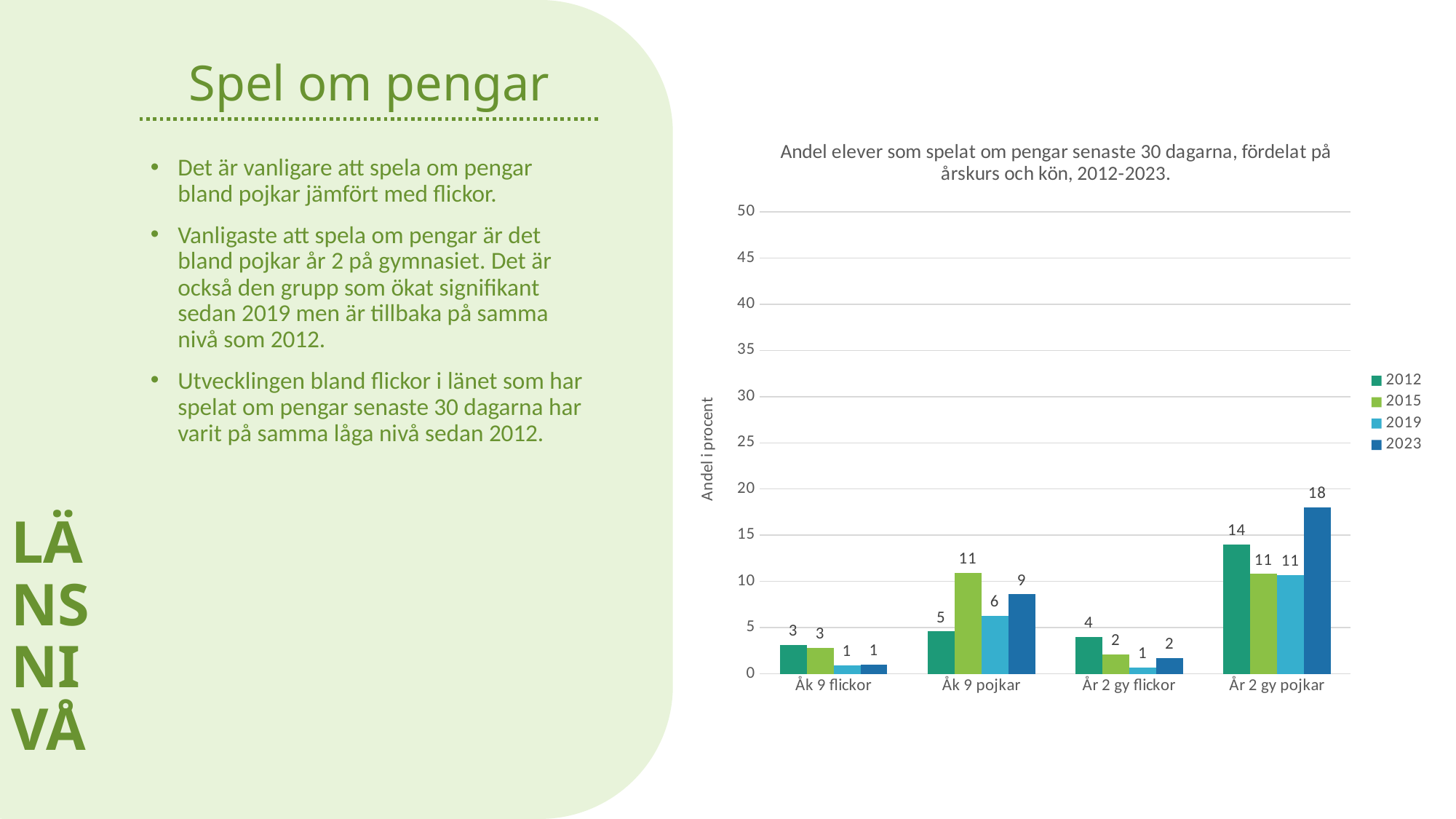
What type of chart is shown on the slide? bar chart Which category has the highest value for the 2023 series? År 2 gy pojkar Which category has the lowest value for the 2012 series? Åk 9 flickor What is the value for 2015 in the 'Åk 9 pojkar' category? 11 What is the label of the vertical axis? Andel i procent What is the value for 2012 in the 'År 2 gy flickor' category? 4 What is the difference between the 2023 and 2012 values for 'År 2 gy pojkar'? 4 How many categories are shown on the x axis? 4 Is the value for 2012 in 'År 2 gy pojkar' greater or less than 10? greater How many series does the legend list? 4 What is the value for 2023 in the 'År 2 gy pojkar' category? 18 Which is larger for 'Åk 9 pojkar': the 2015 value or the 2019 value? 2015